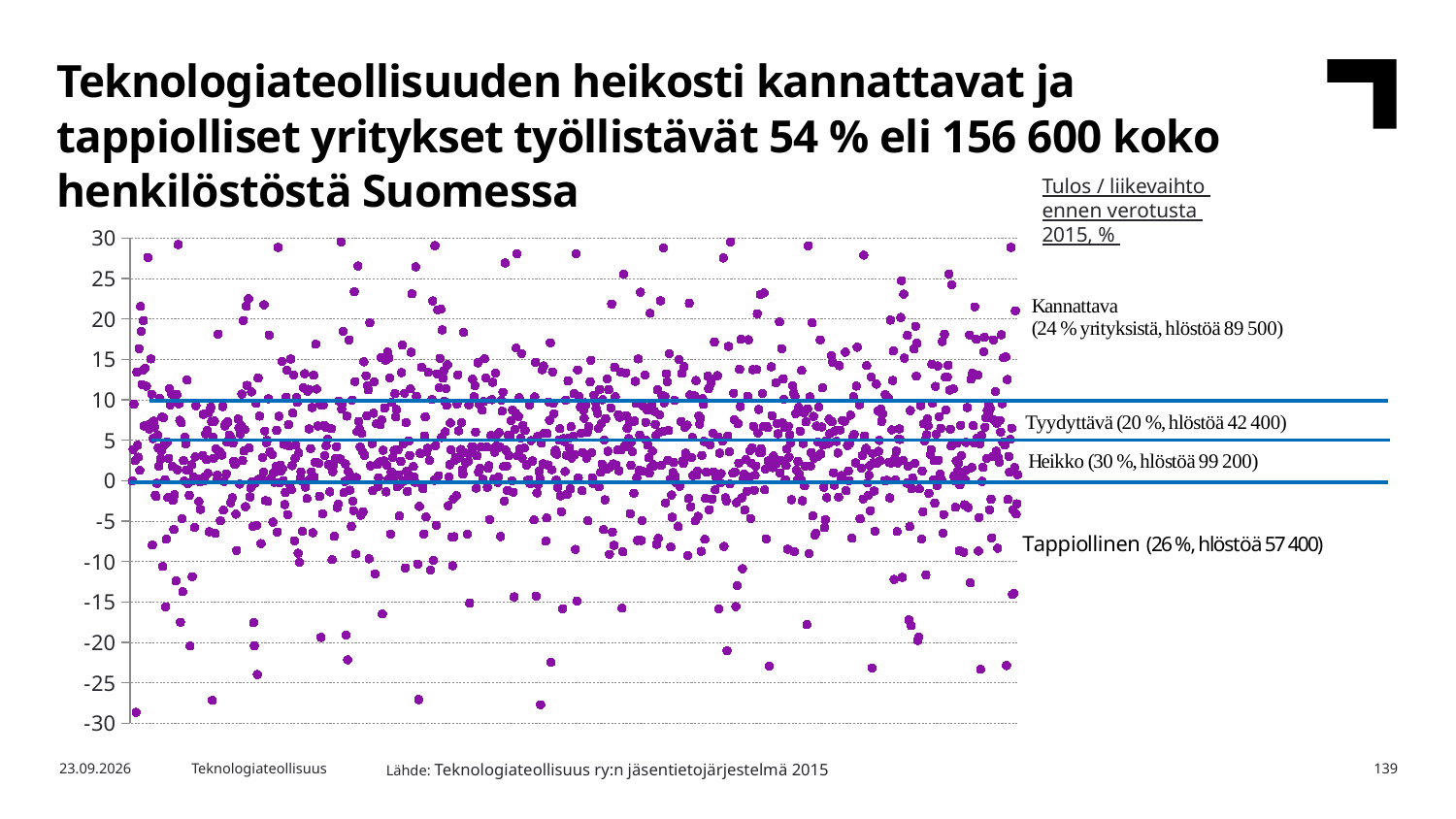
Which category has more personnel, Kannattava or Tappiollinen? Kannattava What is the difference in personnel between the Heikko and Kannattava categories? 9 700 According to the chart annotation, what share of companies are in the Kannattava category? 24 % What is the lowest value shown on the vertical axis of the chart? -30 According to the chart annotation, how many personnel (hlöstöä) are in the Heikko category? 99 200 Which category has the largest share of companies according to the chart annotations? Heikko Which category has the smallest number of personnel according to the chart annotations? Tyydyttävä According to the chart annotation, what share of companies are in the Tappiollinen category? 26 % What kind of chart is shown on the slide? Scatter plot What is the highest value shown on the vertical axis of the chart? 30 How many horizontal blue threshold lines are drawn across the chart? 3 According to the chart annotation, how many personnel (hlöstöä) are in the Tyydyttävä category? 42 400